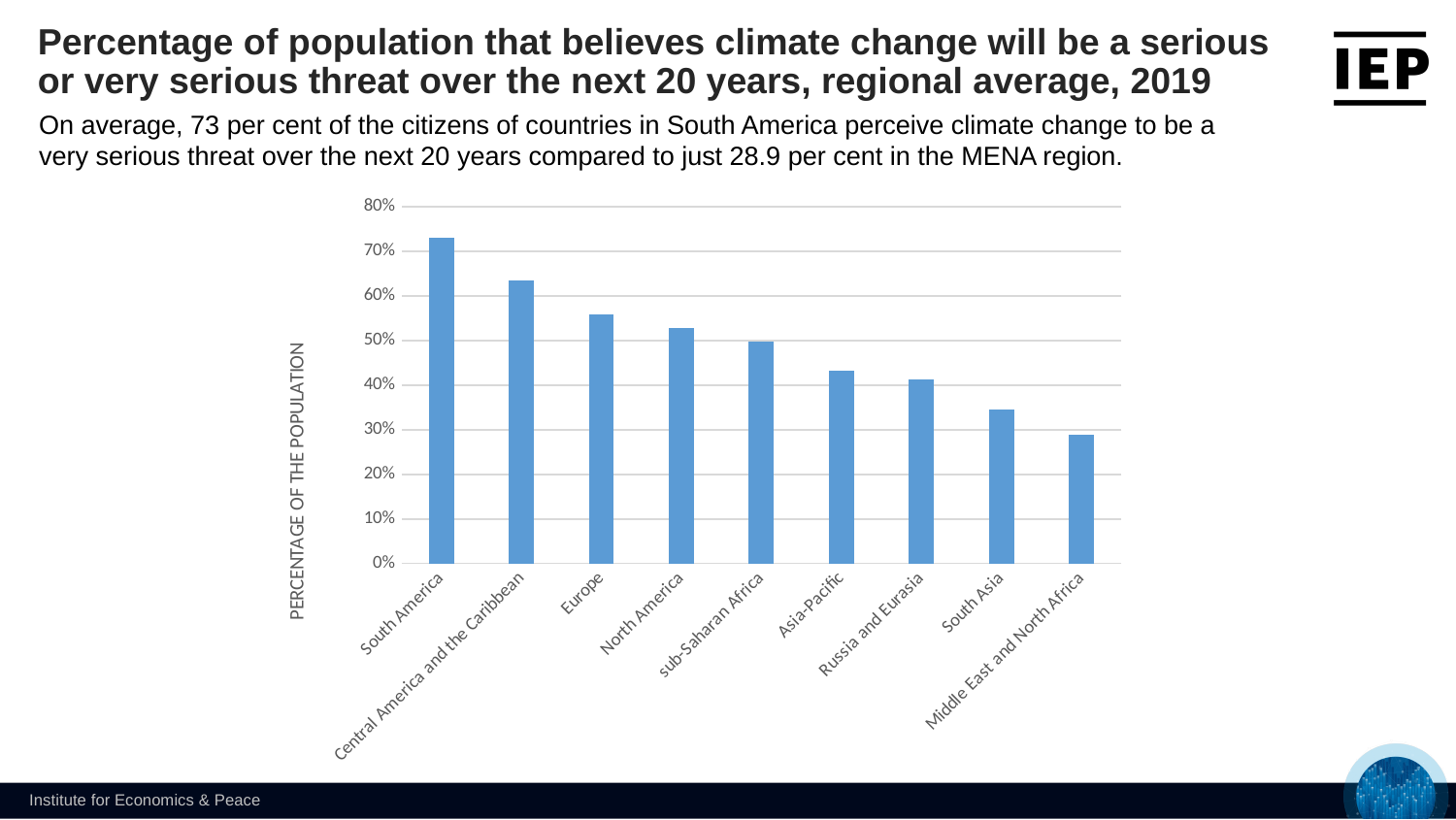
Is the value for Asia-Pacific greater or less than 40%? greater Which region has the highest percentage of population that believes climate change will be a serious or very serious threat? South America Which region has a higher value, Europe or South Asia? Europe What is the label on the vertical axis of the chart? PERCENTAGE OF THE POPULATION According to the slide, what percentage of citizens in South America perceive climate change to be a very serious threat over the next 20 years? 73 per cent What type of chart is shown on the slide? Bar chart According to the slide, what percentage of citizens in the MENA region perceive climate change to be a very serious threat over the next 20 years? 28.9 per cent How many regions are shown on the x axis of the chart? 9 Do the values rise or fall moving from left to right along the x axis? Fall Which region has the lowest percentage of population that believes climate change will be a serious or very serious threat? Middle East and North Africa Is the value for Central America and the Caribbean greater or less than 60%? greater Is the value for South Asia greater or less than 40%? less